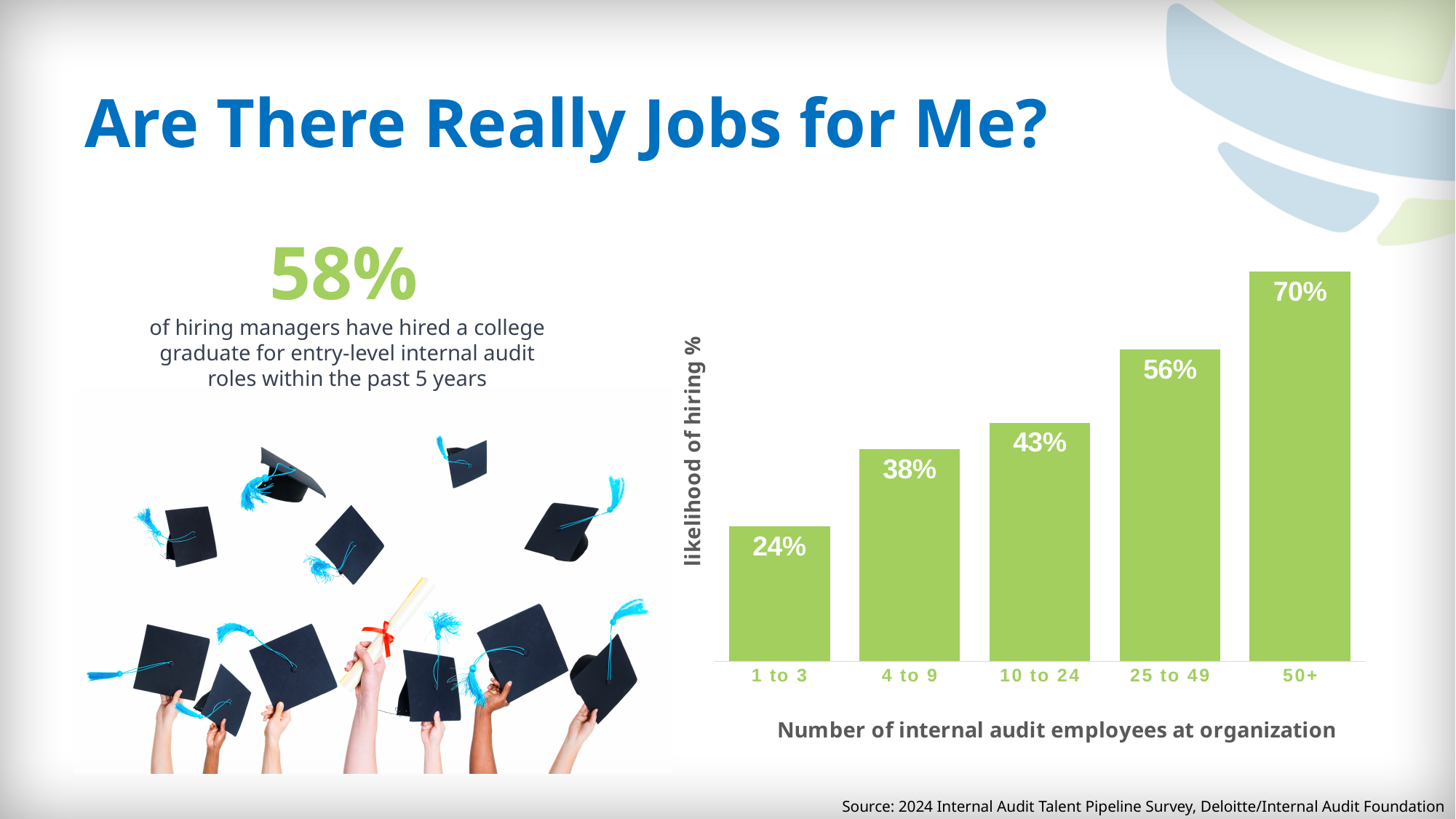
How many organization size categories are shown in the chart? 5 What kind of chart is used to show likelihood of hiring by organization size? Bar chart What is the likelihood of hiring for organizations with 50+ internal audit employees? 70% What is the likelihood of hiring for organizations with 1 to 3 internal audit employees? 24% What is the label of the x axis of the chart? Number of internal audit employees at organization What is the difference in likelihood of hiring between the 25 to 49 category and the 4 to 9 category? 18% Does the likelihood of hiring rise or fall as the number of internal audit employees increases? Rise Which has a higher likelihood of hiring: 4 to 9 employees or 10 to 24 employees? 10 to 24 What is the difference in likelihood of hiring between the 50+ category and the 1 to 3 category? 46% Which organization size category has the lowest likelihood of hiring? 1 to 3 Which organization size category has the highest likelihood of hiring? 50+ What is the likelihood of hiring for organizations with 10 to 24 internal audit employees? 43%